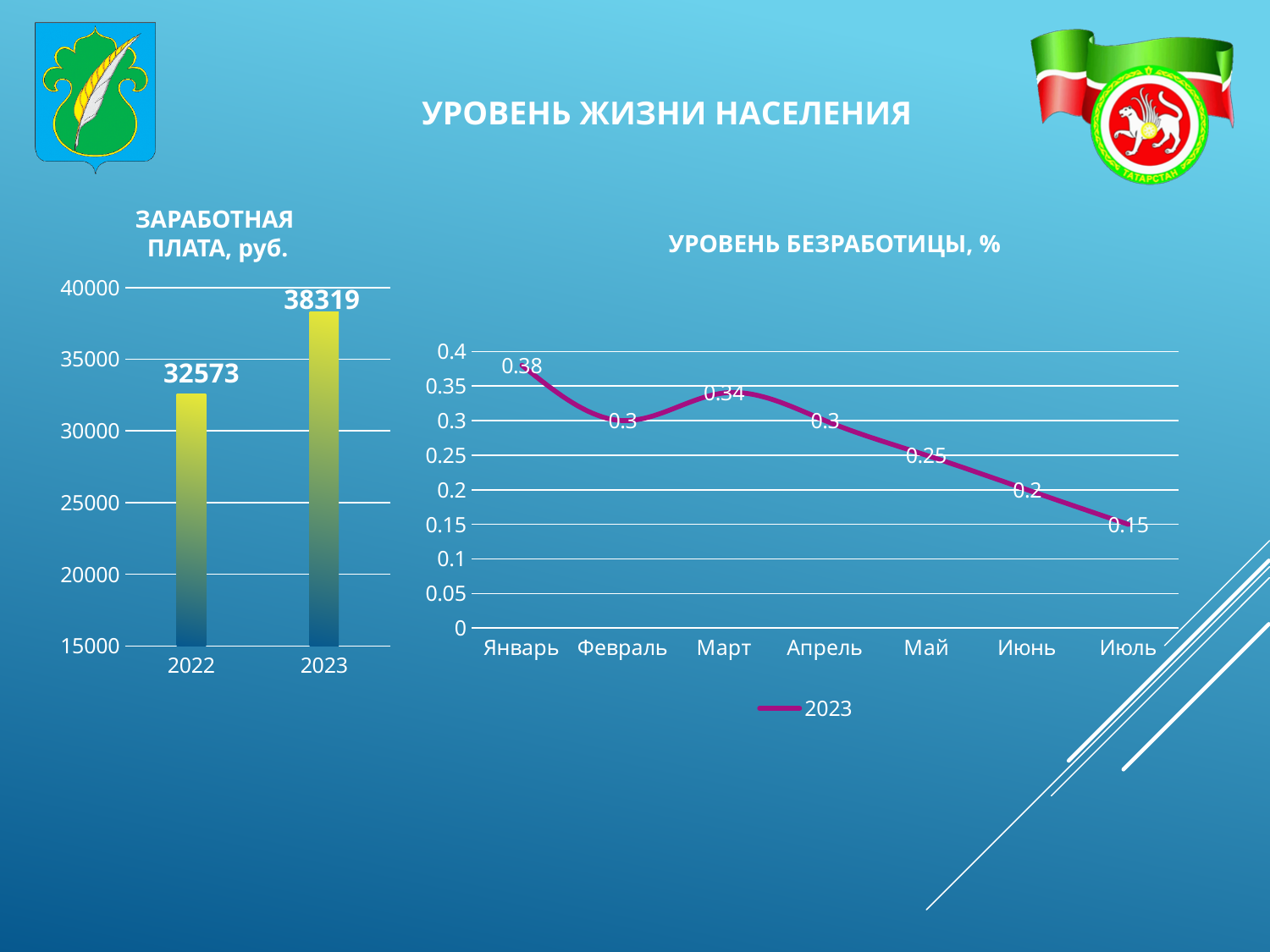
In the 'ЗАРАБОТНАЯ ПЛАТА, руб.' chart, what is the difference between the 2023 and 2022 values? 5746 In the 'УРОВЕНЬ БЕЗРАБОТИЦЫ, %' chart, what series does the legend list? 2023 In the 'УРОВЕНЬ БЕЗРАБОТИЦЫ, %' chart, what is the difference between the Март and Май values? 0.09 What kind of chart is the 'ЗАРАБОТНАЯ ПЛАТА, руб.' chart? bar chart In the 'ЗАРАБОТНАЯ ПЛАТА, руб.' chart, what is the value for 2023? 38319 In the 'УРОВЕНЬ БЕЗРАБОТИЦЫ, %' chart, how many months are plotted? 7 In the 'УРОВЕНЬ БЕЗРАБОТИЦЫ, %' chart, which month has the highest value? Январь In the 'УРОВЕНЬ БЕЗРАБОТИЦЫ, %' chart, what is the value for Июль? 0.15 In the 'УРОВЕНЬ БЕЗРАБОТИЦЫ, %' chart, which month has the lowest value? Июль In the 'ЗАРАБОТНАЯ ПЛАТА, руб.' chart, which year has the higher value? 2023 In the 'ЗАРАБОТНАЯ ПЛАТА, руб.' chart, what is the value for 2022? 32573 In the 'УРОВЕНЬ БЕЗРАБОТИЦЫ, %' chart, what is the value for Январь? 0.38